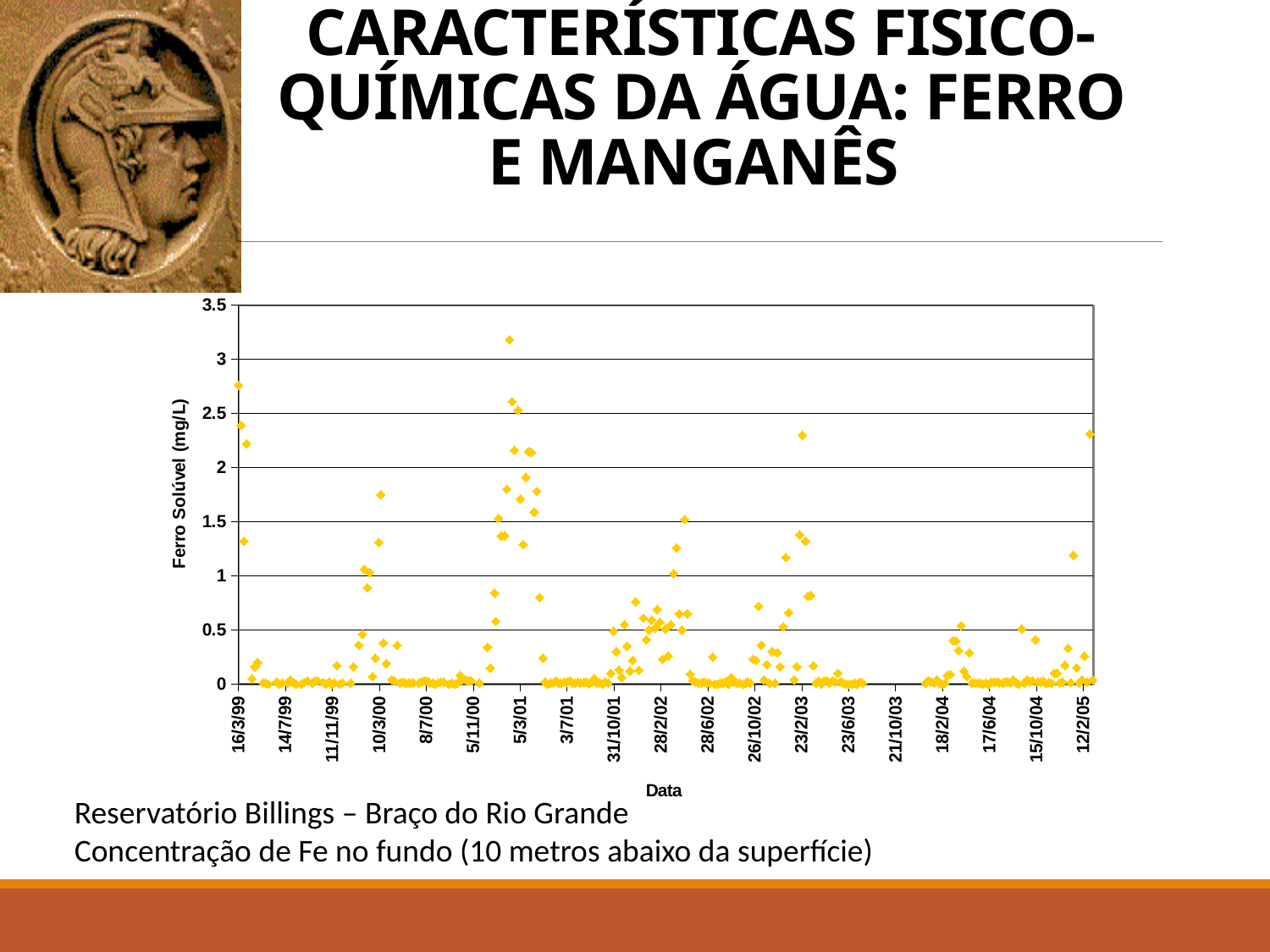
What is the last date label shown on the x-axis? 12/2/05 Near which x-axis date label does the highest plotted point occur? 5/3/01 Is the highest point plotted near 10/3/00 greater or less than 2? less What kind of chart is shown on the slide? Scatter chart What is the title of the y-axis of the chart? Ferro Solúvel (mg/L) How many date labels are shown on the x-axis? 19 Is the highest plotted value in the chart greater or less than 3.5? less Is the highest plotted value in the chart greater or less than 3? greater What is the first date label shown on the x-axis? 16/3/99 What is the highest tick value shown on the y-axis? 3.5 What is the title of the x-axis of the chart? Data